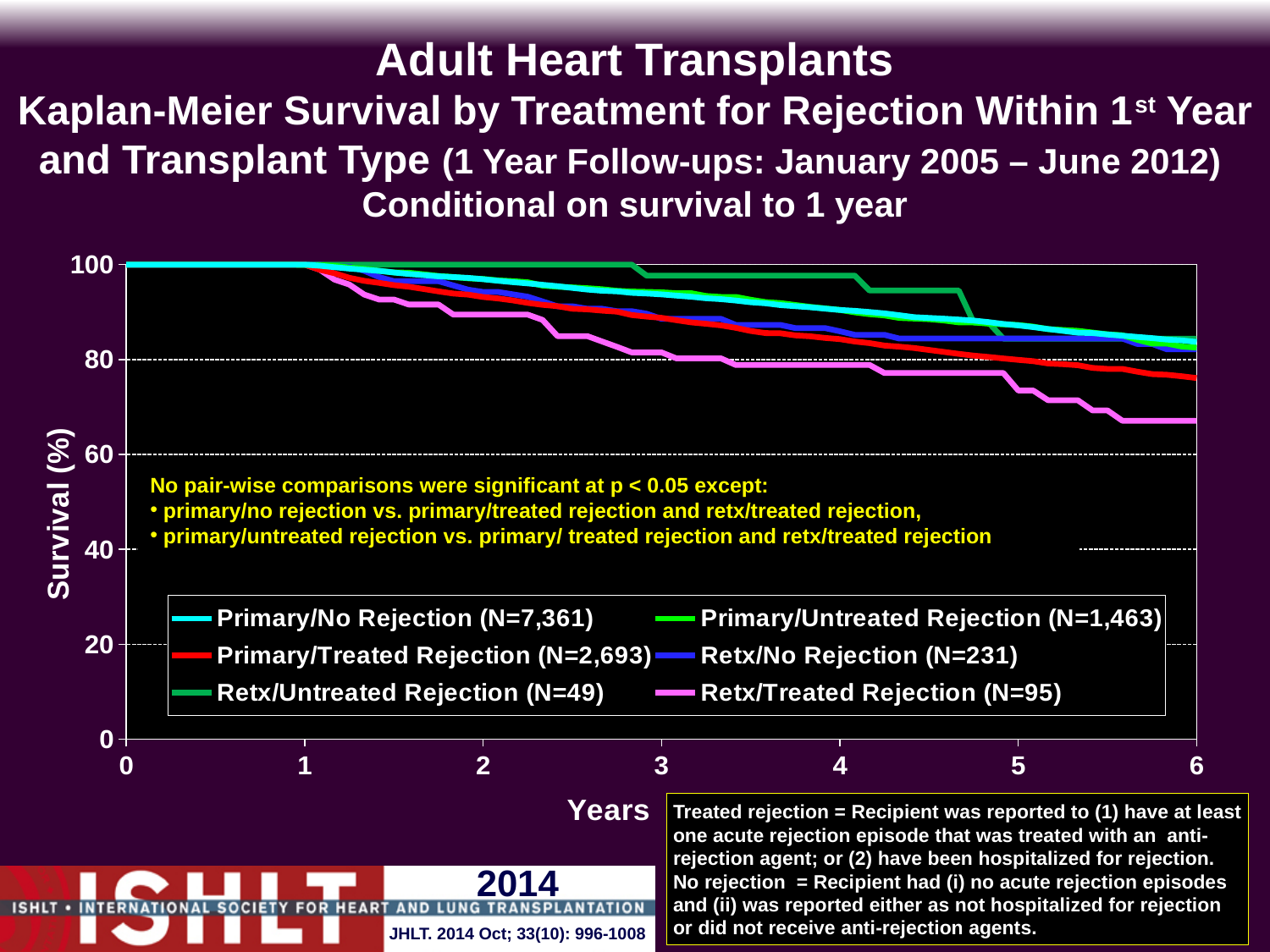
What kind of chart is shown on the slide? Line chart At 6 years, which has higher survival: Primary/Treated Rejection or Retx/Treated Rejection? Primary/Treated Rejection Is the survival for Retx/Untreated Rejection at 4 years greater or less than 80? greater Which series has the lowest survival at 6 years? Retx/Treated Rejection Do the survival curves rise or fall as years increase? Fall How many series does the legend list? 6 Is the survival for Primary/Treated Rejection at 6 years greater or less than 80? less Is the survival for Primary/No Rejection at 6 years greater or less than 80? greater What is the label of the y-axis? Survival (%) What is the N for the Primary/No Rejection group shown in the legend? N=7,361